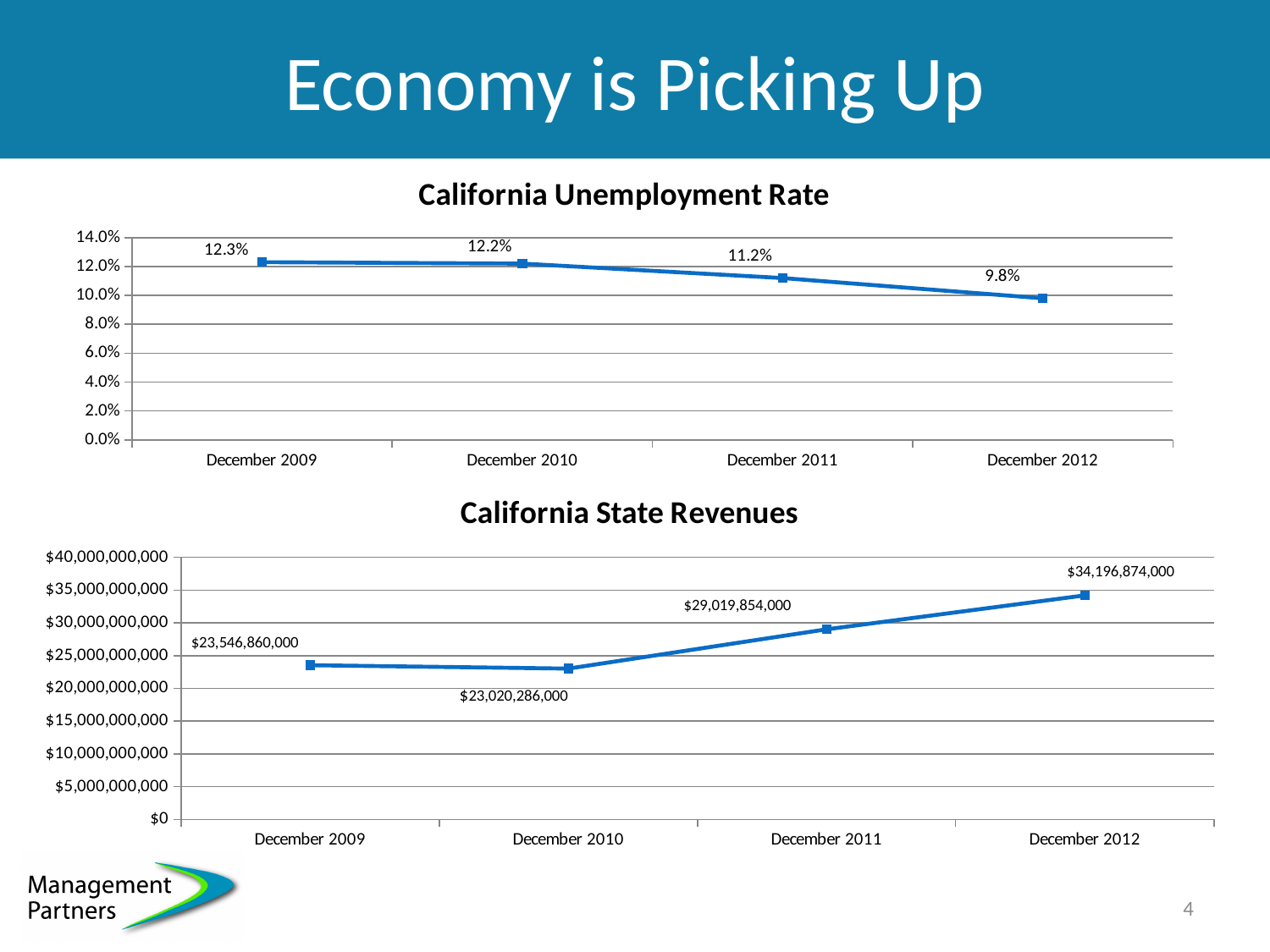
In the California Unemployment Rate chart, do the values rise or fall from December 2009 to December 2012? fall In the California Unemployment Rate chart, which date has the highest unemployment rate? December 2009 In the California Unemployment Rate chart, what was the unemployment rate in December 2010? 12.2% What kind of chart is the California State Revenues chart? line chart In the California State Revenues chart, which is larger, the revenue for December 2009 or December 2010? December 2009 In the California State Revenues chart, what were the revenues in December 2010? $23,020,286,000 In the California State Revenues chart, what were the revenues in December 2011? $29,019,854,000 In the California Unemployment Rate chart, by how many percentage points did the rate fall from December 2009 to December 2012? 2.5 percentage points In the California Unemployment Rate chart, which date has the lowest unemployment rate? December 2012 In the California State Revenues chart, what is the difference between the December 2012 and December 2011 revenues? $5,177,020,000 In the California Unemployment Rate chart, what was the unemployment rate in December 2012? 9.8% In the California State Revenues chart, which date has the highest revenues? December 2012